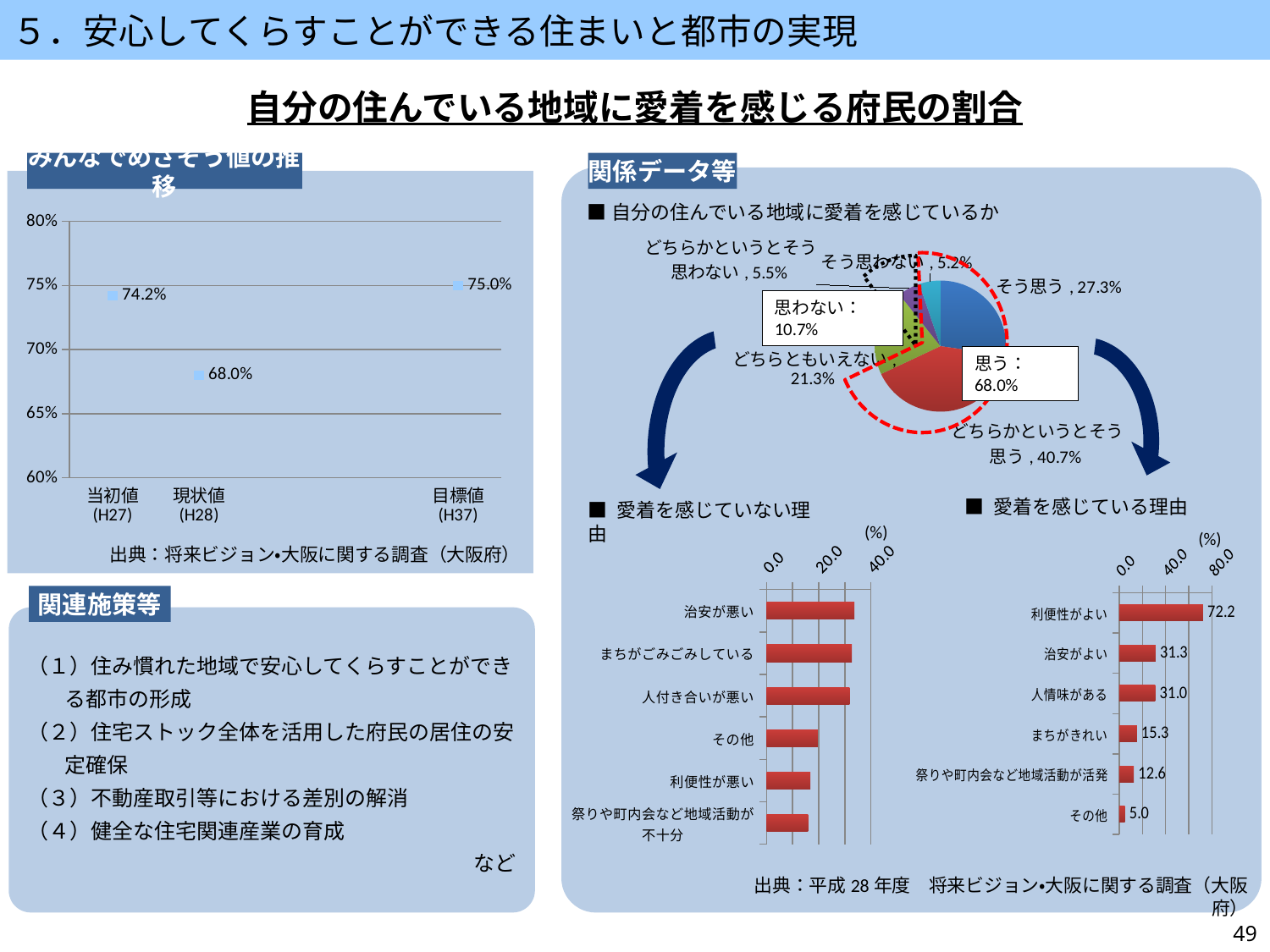
In the pie chart 自分の住んでいる地域に愛着を感じているか, what share does どちらかというとそう思う have? 40.7% In the chart titled みんなでめざそう値の推移, what is the value for 現状値 (H28)? 68.0% In the chart 愛着を感じていない理由, is the value for 治安が悪い greater or less than 20.0? greater In the chart titled みんなでめざそう値の推移, what is the value for 目標値 (H37)? 75.0% How many slices does the pie chart 自分の住んでいる地域に愛着を感じているか have? 5 What kind of chart is 愛着を感じていない理由? bar chart In the chart titled みんなでめざそう値の推移, which point has the lowest value? 現状値 (H28) In the chart titled みんなでめざそう値の推移, what is the difference between the 当初値 (H27) value and the 現状値 (H28) value? 6.2% In the pie chart 自分の住んでいる地域に愛着を感じているか, what is the combined share labelled 思わない? 10.7% In the chart 愛着を感じている理由, what is the difference between 利便性がよい and まちがきれい? 56.9 In the pie chart 自分の住んでいる地域に愛着を感じているか, which slice is the largest? どちらかというとそう思う In the chart 愛着を感じている理由, what is the value for 治安がよい? 31.3